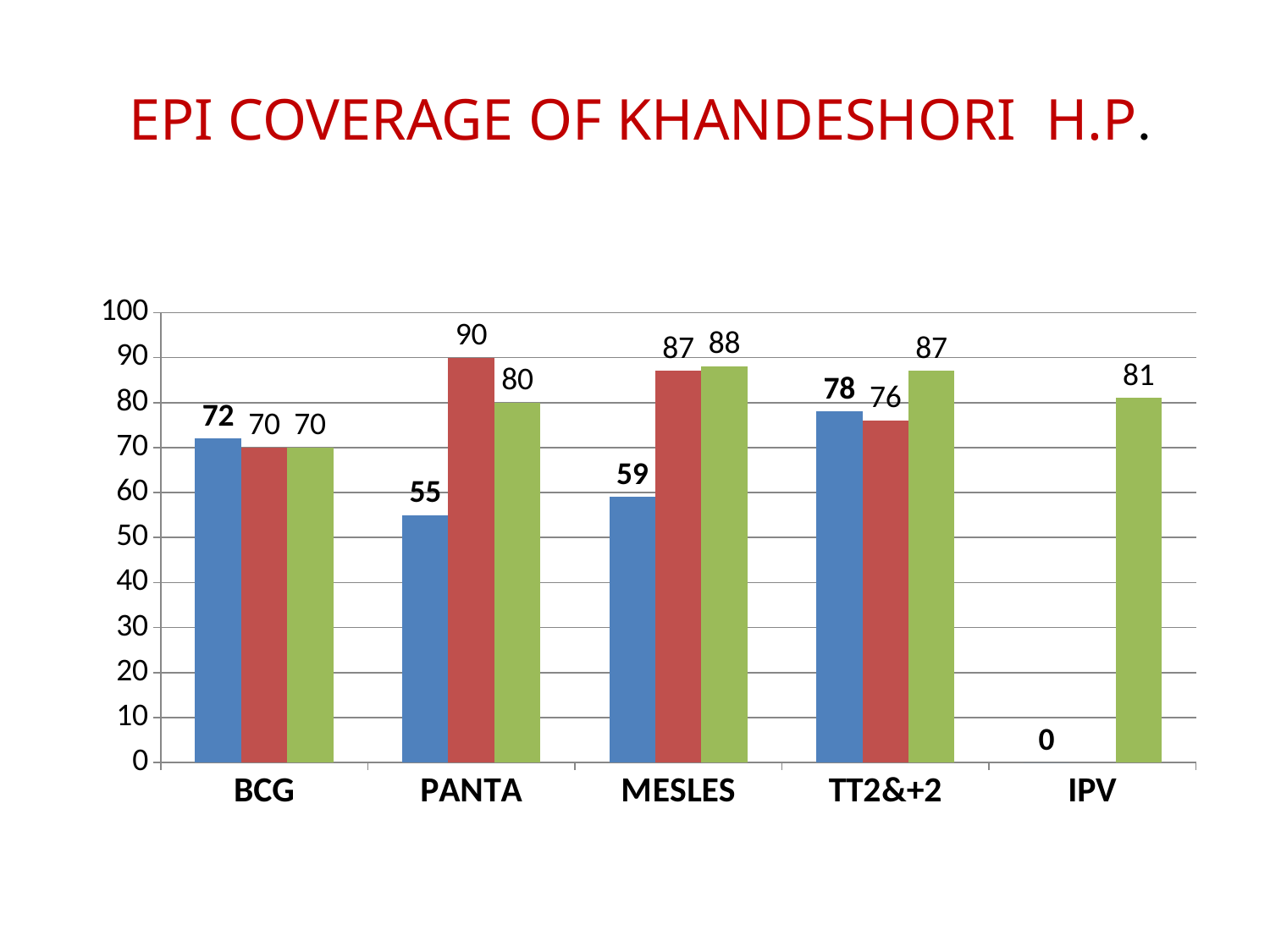
Which is larger for TT2&+2, the blue bar or the green bar? the green bar What is the difference between the red bar and the blue bar for PANTA? 35 What is the value of the green bar for IPV? 81 What is the value of the red bar for PANTA? 90 What type of chart is shown on the slide? bar chart What is the value of the blue bar for BCG? 72 What is the value of the green bar for MESLES? 88 What is the title of the chart? EPI COVERAGE OF KHANDESHORI H.P. Which category has the highest red bar value? PANTA How many categories are shown on the x axis? 5 What is the difference between the green bar for TT2&+2 and the red bar for TT2&+2? 11 Which category has the lowest blue bar value? IPV